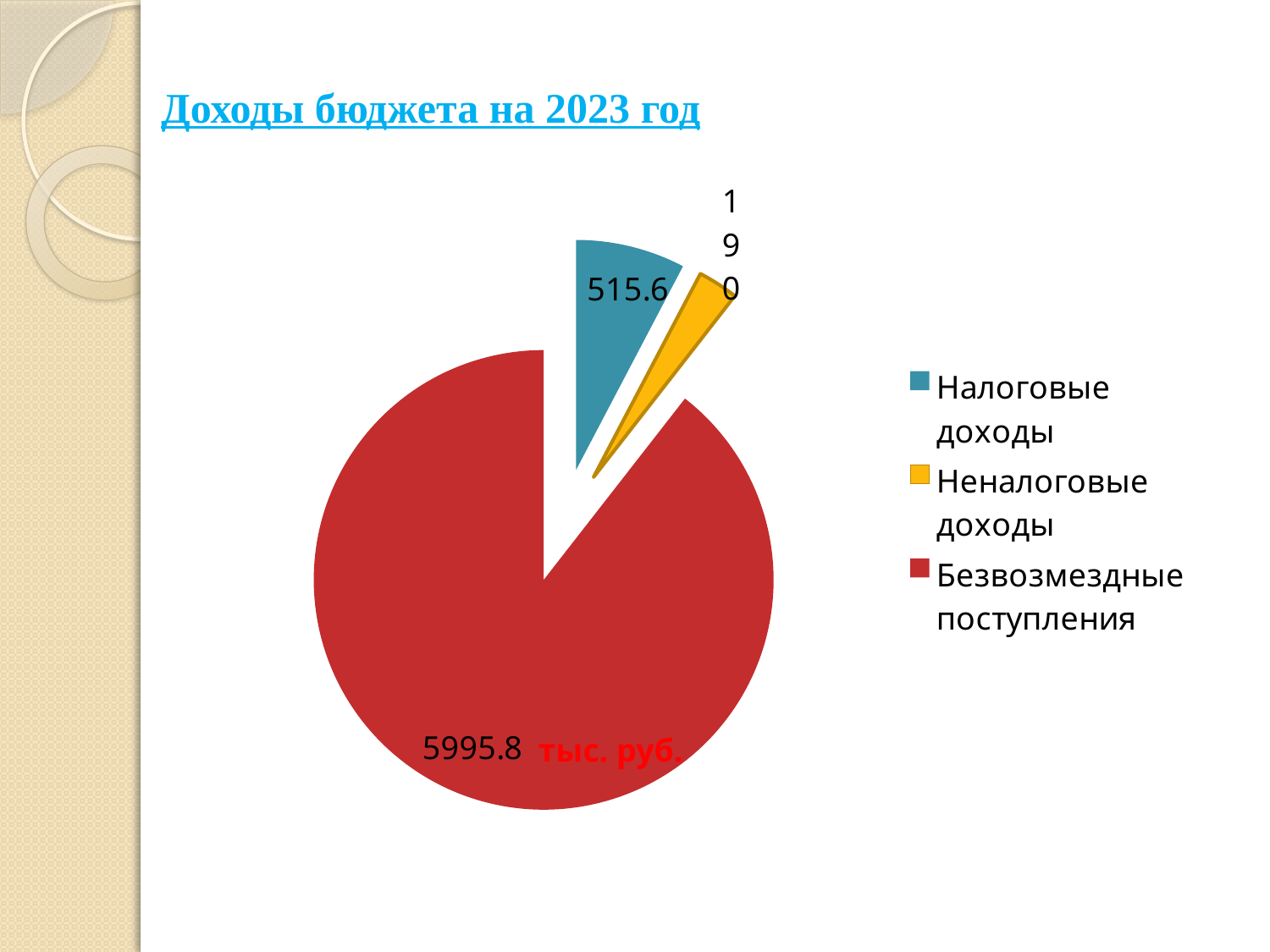
Which category has the smallest slice of the pie? Неналоговые доходы Which is larger, Налоговые доходы or Неналоговые доходы? Налоговые доходы Which category has the largest slice of the pie? Безвозмездные поступления How many entries does the legend list? 3 How many slices does the pie chart have? 3 What is the value for Неналоговые доходы? 190 What is the value for Безвозмездные поступления? 5995.8 What is the difference between Безвозмездные поступления and Налоговые доходы? 5480.2 What colour is the slice for Безвозмездные поступления? red What is the value for Налоговые доходы? 515.6 What type of chart is shown on the slide? pie chart What is the title of the chart on the slide? Доходы бюджета на 2023 год